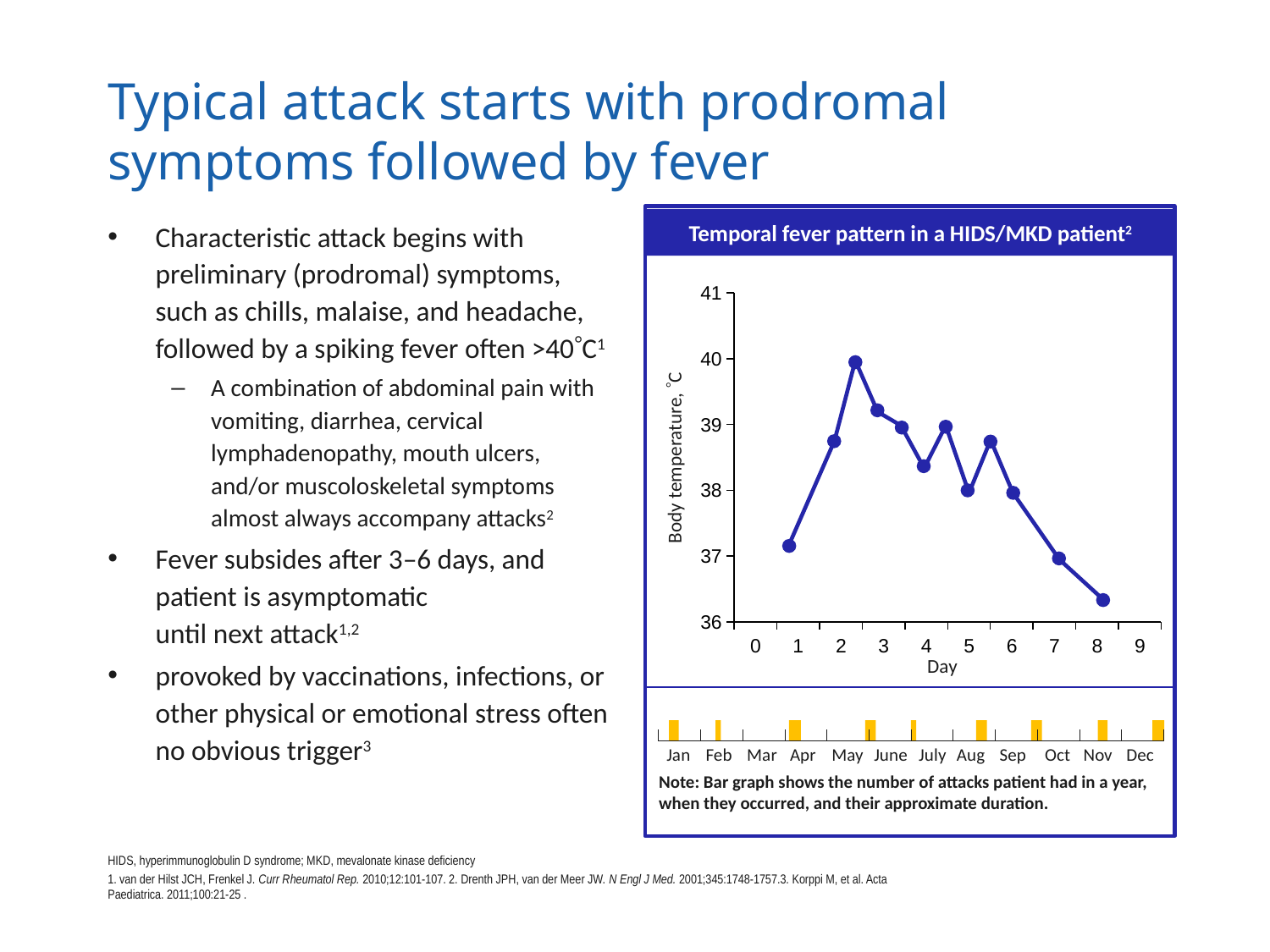
What is the label of the y axis on the body temperature line chart? Body temperature, °C On the body temperature line chart, does body temperature generally rise or fall from the peak (around day 2–3) to the end of the series? fall On the body temperature line chart, which is higher: the first plotted point (near day 1) or the last plotted point (near day 8)? the first plotted point On the body temperature line chart, is the last plotted body temperature (near day 8) greater or less than 37? less What is the title of the chart panel on the right of the slide? Temporal fever pattern in a HIDS/MKD patient How many months are labelled on the x axis of the bar graph of attacks below the line chart? 12 On the body temperature line chart, is the first plotted body temperature (near day 1) greater or less than 38? less What is the highest value shown on the y axis of the body temperature line chart? 41 How many data points are plotted on the body temperature line chart? 12 On the body temperature line chart, is the lowest plotted body temperature greater or less than 37? less What kind of chart is used to show body temperature over days in the 'Temporal fever pattern in a HIDS/MKD patient' panel? line chart